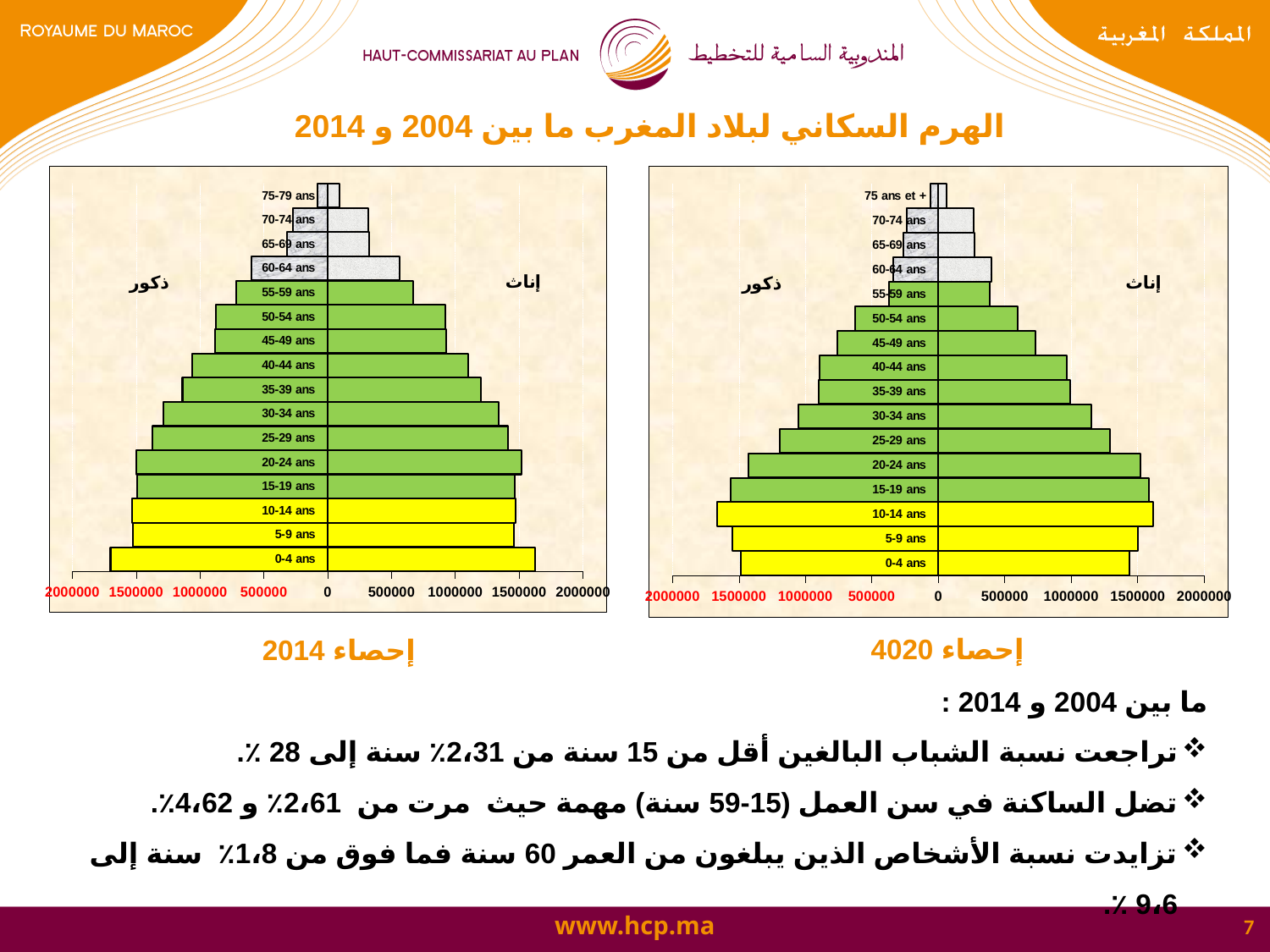
In the 2004 census chart on the right, which age group has the larger bars, 10-14 ans or 0-4 ans? 10-14 ans In the 2014 census chart on the left, what colour are the bars for the 0-4, 5-9 and 10-14 age groups? yellow In the 2004 census chart on the right, which age group has the widest bars? 10-14 ans In the 2014 census chart on the left, is the female (إناث) value for 0-4 ans greater or less than 1000000? greater In the 2014 census chart on the left, which age group has the narrowest bars? 75-79 ans In the 2014 census chart on the left, is the female (إناث) value for 65-69 ans greater or less than 500000? less In the 2004 census chart on the right, which age group has the narrowest bars? 75 ans et + What kind of chart is the 2014 census chart (إحصاء 2014) on the left? bar chart (population pyramid) In the 2014 census chart on the left, which age group has the widest bars? 0-4 ans How many age groups are shown in the 2014 census chart on the left? 16 How many age groups are shown in the 2004 census chart (إحصاء 2004) on the right? 16 In the 2004 census chart on the right, is the male (ذكور) value for 70-74 ans greater or less than 500000? less